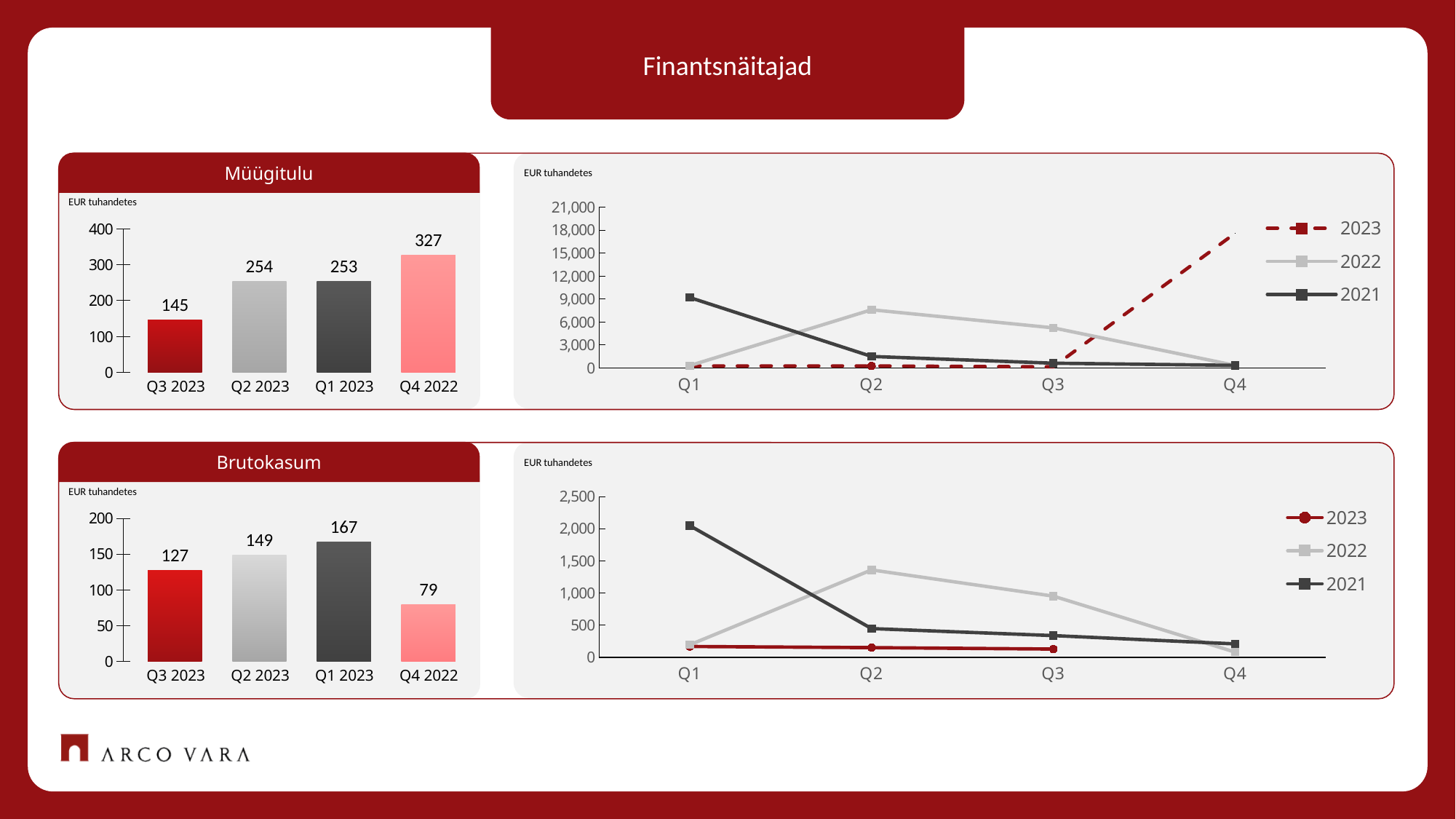
In the Müügitulu bar chart, what is the value for Q4 2022? 327 How many series does the legend of the top-right line chart list? 3 In the Brutokasum bar chart, what is the difference between Q1 2023 and Q4 2022? 88 In the Brutokasum bar chart, what is the value for Q2 2023? 149 How many bars are in the Brutokasum bar chart? 4 What kind of chart is the bottom-right chart on the slide? line chart In the Brutokasum bar chart, which quarter has the highest value? Q1 2023 In the bottom-right line chart, does the 2021 series rise or fall from Q1 to Q4? fall In the Müügitulu bar chart, what is the difference between Q4 2022 and Q3 2023? 182 In the Müügitulu bar chart, which quarter has the lowest value? Q3 2023 In the top-right line chart, is the 2023 value at Q4 greater or less than 15,000? greater In the Brutokasum bar chart, which is larger, Q3 2023 or Q4 2022? Q3 2023